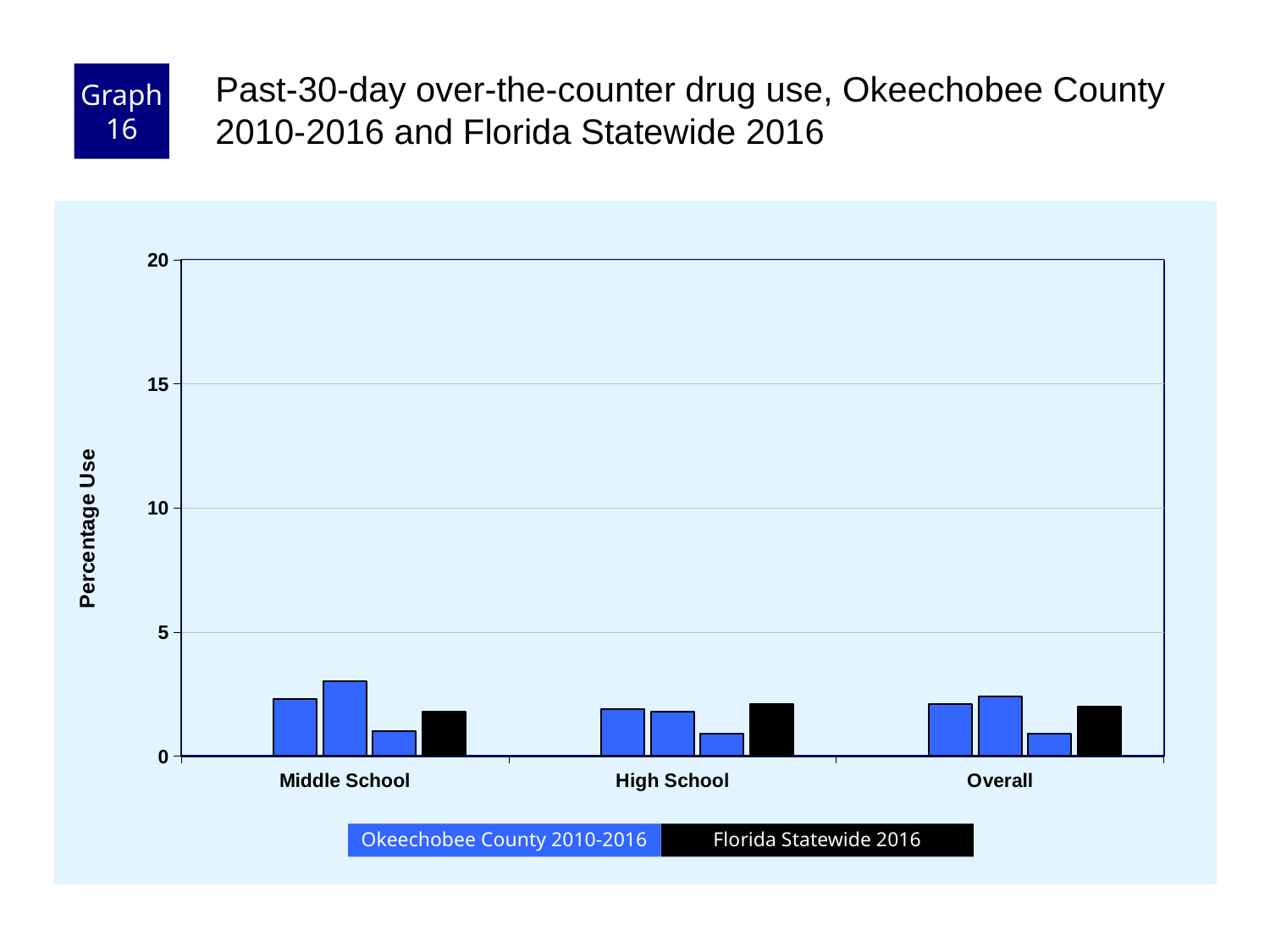
Which colour represents Florida Statewide 2016 in the legend? black Are any of the Okeechobee County 2010-2016 bars greater than 5? No Is the value for Florida Statewide 2016 for High School greater or less than 5? less Is the value for Florida Statewide 2016 for Overall greater or less than 10? less How many series does the legend list? 2 In the Overall group, is the tallest bar an Okeechobee County 2010-2016 bar or the Florida Statewide 2016 bar? Okeechobee County 2010-2016 What is the label on the y axis? Percentage Use Which category contains the tallest bar in the chart? Middle School In the Middle School group, is the tallest bar an Okeechobee County 2010-2016 bar or the Florida Statewide 2016 bar? Okeechobee County 2010-2016 How many categories are shown on the x axis? 3 What kind of chart is shown on the slide? bar chart